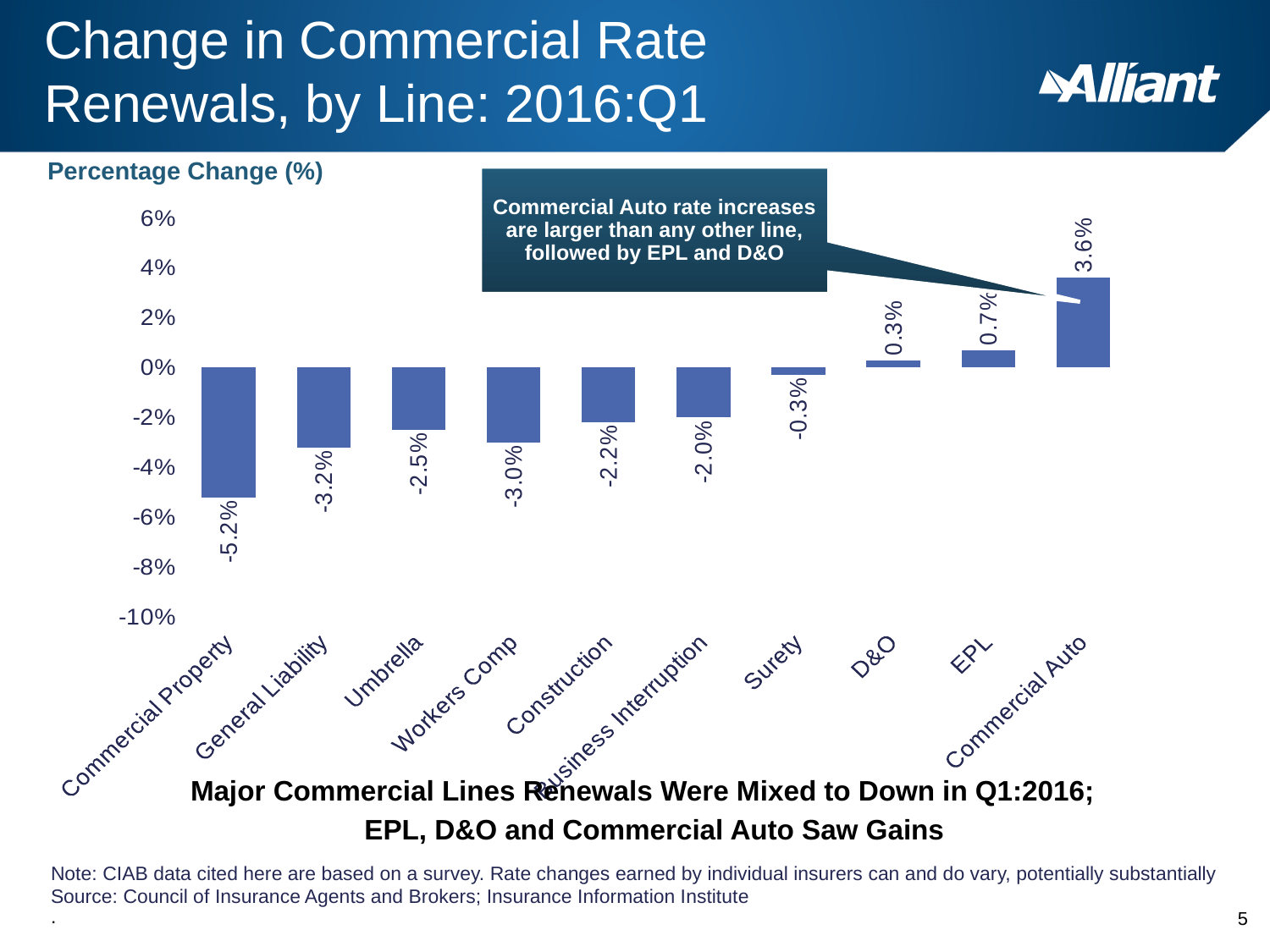
Which line has the highest percentage change? Commercial Auto What is the label on the vertical axis of the chart? Percentage Change (%) What kind of chart is shown on the slide? Bar chart Which line has the lowest percentage change? Commercial Property What is the percentage change for Commercial Property? -5.2% What is the percentage change for Surety? -0.3% How many lines are shown in the chart? 10 What is the percentage change for Commercial Auto? 3.6% What is the percentage change for Workers Comp? -3.0% Is the value for Commercial Auto greater or less than 2%? greater What is the difference between the percentage change for Commercial Auto and EPL? 2.9% Which has a larger percentage change, General Liability or Umbrella? Umbrella